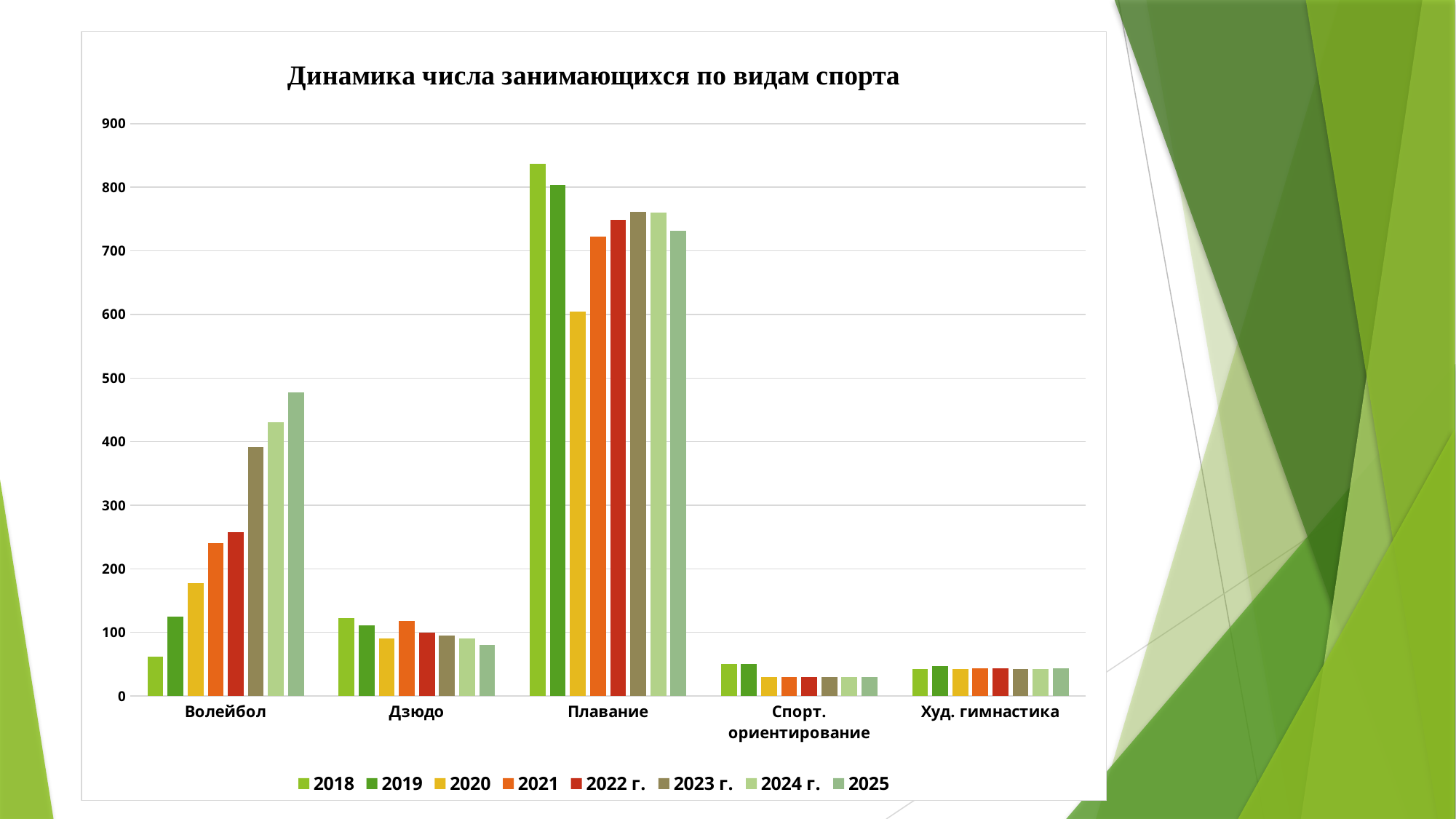
Which sport has the highest value for 2018? Плавание Is the value for Плавание in 2018 greater or less than 800? greater For Плавание, which year has the lowest value? 2020 Which is larger in 2025: Волейбол or Дзюдо? Волейбол Which sport has the lowest value for 2021? Спорт. ориентирование Do the values for Волейбол rise or fall from 2018 to 2025? rise How many sport categories are shown on the x axis? 5 How many series does the legend list? 8 Is the value for Плавание in 2020 greater or less than 700? less What kind of chart is shown on the slide? bar chart What is the title of the chart? Динамика числа занимающихся по видам спорта Is the value for Волейбол in 2025 greater or less than 400? greater